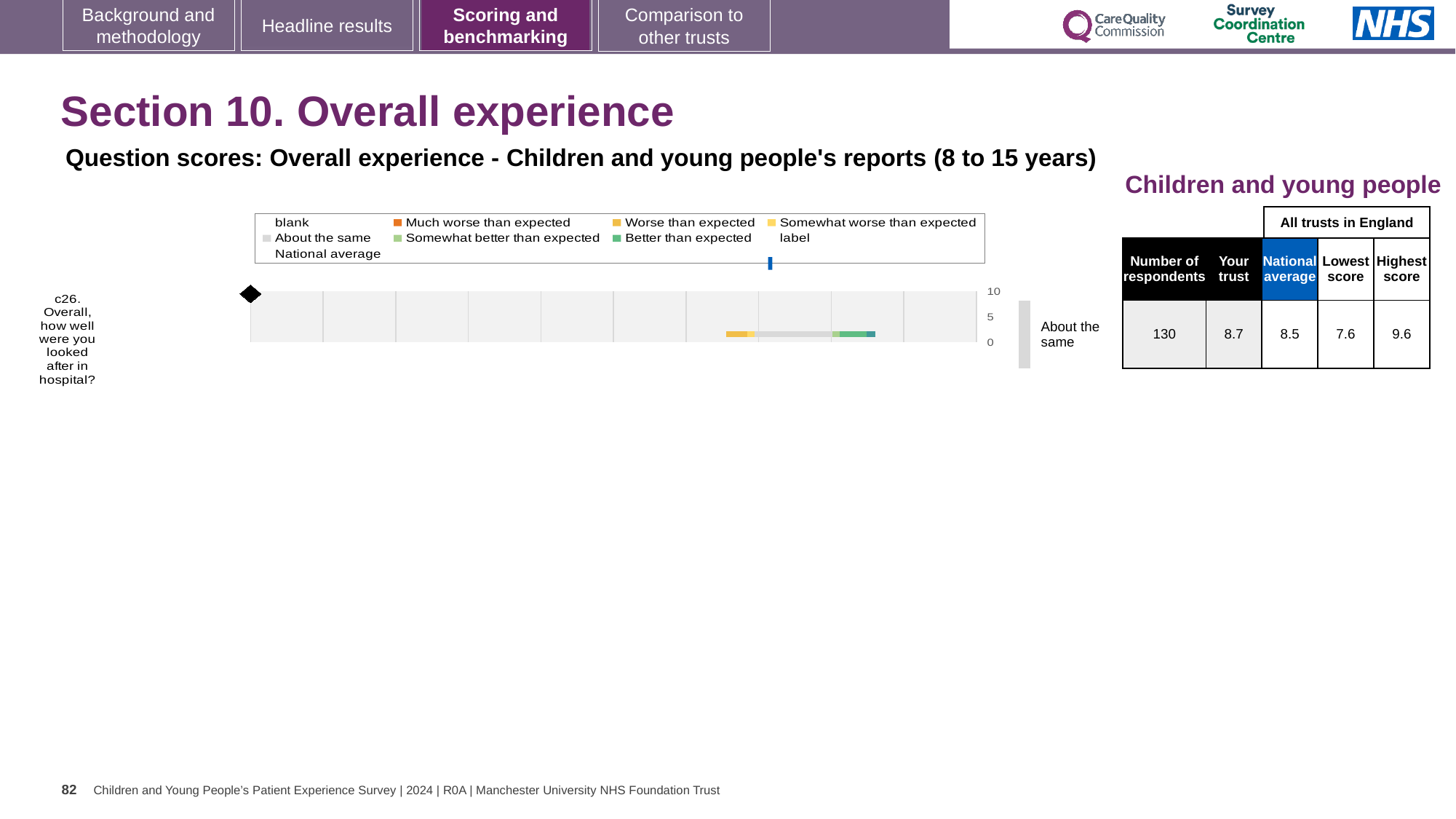
What is the national average score for question c26? 8.5 What is the 'Your trust' score for question c26 (Overall, how well were you looked after in hospital?)? 8.7 How many survey questions are plotted on the chart? 1 How many respondents answered question c26? 130 What kind of chart is used to show the question score? bar chart What is the highest score among all trusts in England for question c26? 9.6 What is the difference between the trust's score and the national average for c26? 0.2 What is the lowest score among all trusts in England for question c26? 7.6 What is the difference between the highest and lowest trust scores for c26? 2.0 Which age group's reports does the chart cover, according to the subtitle? Children and young people (8 to 15 years) Is the trust's score for c26 higher or lower than the national average? higher What benchmarking category is shown next to the bar for question c26? About the same